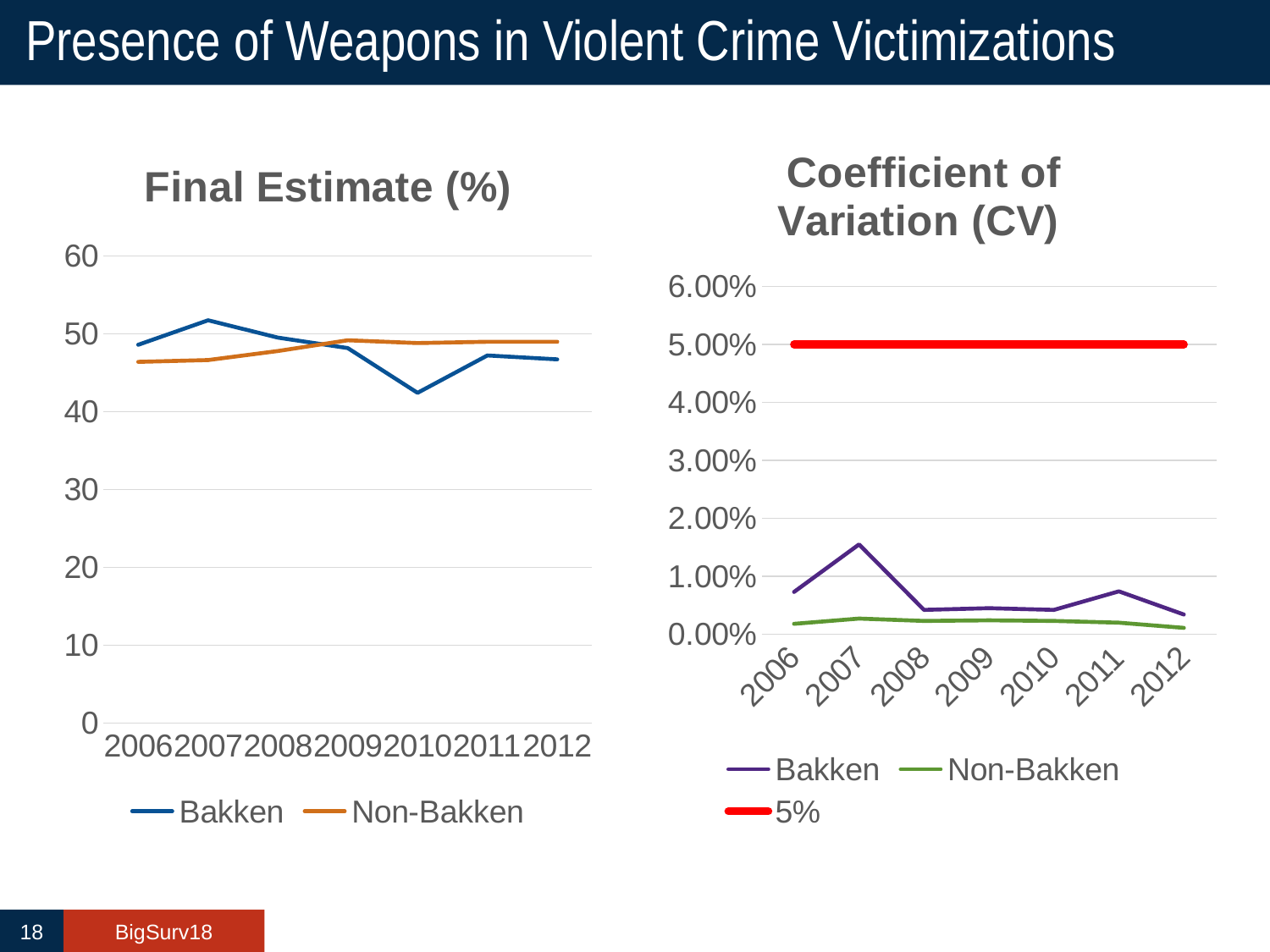
In the "Final Estimate (%)" chart, in which year does the Bakken series reach its highest value? 2007 In the "Coefficient of Variation (CV)" chart, in which year does the Bakken series reach its highest value? 2007 How many series does the legend of the "Coefficient of Variation (CV)" chart list? 3 How many years are shown on the x axis of the "Final Estimate (%)" chart? 7 In the "Final Estimate (%)" chart, is the Bakken value for 2010 greater or less than 50? less In the "Final Estimate (%)" chart, which series has the larger value in 2010, Bakken or Non-Bakken? Non-Bakken In the "Final Estimate (%)" chart, in which year does the Bakken series reach its lowest value? 2010 What kind of chart is the "Final Estimate (%)" chart? line chart What is the title of the chart on the left side of the slide? Final Estimate (%) In the "Coefficient of Variation (CV)" chart, is the Bakken value for 2007 greater or less than 1.00%? greater In the "Coefficient of Variation (CV)" chart, which series has the larger value in 2011, Bakken or Non-Bakken? Bakken In the "Coefficient of Variation (CV)" chart, at what level is the red reference line drawn? 5%